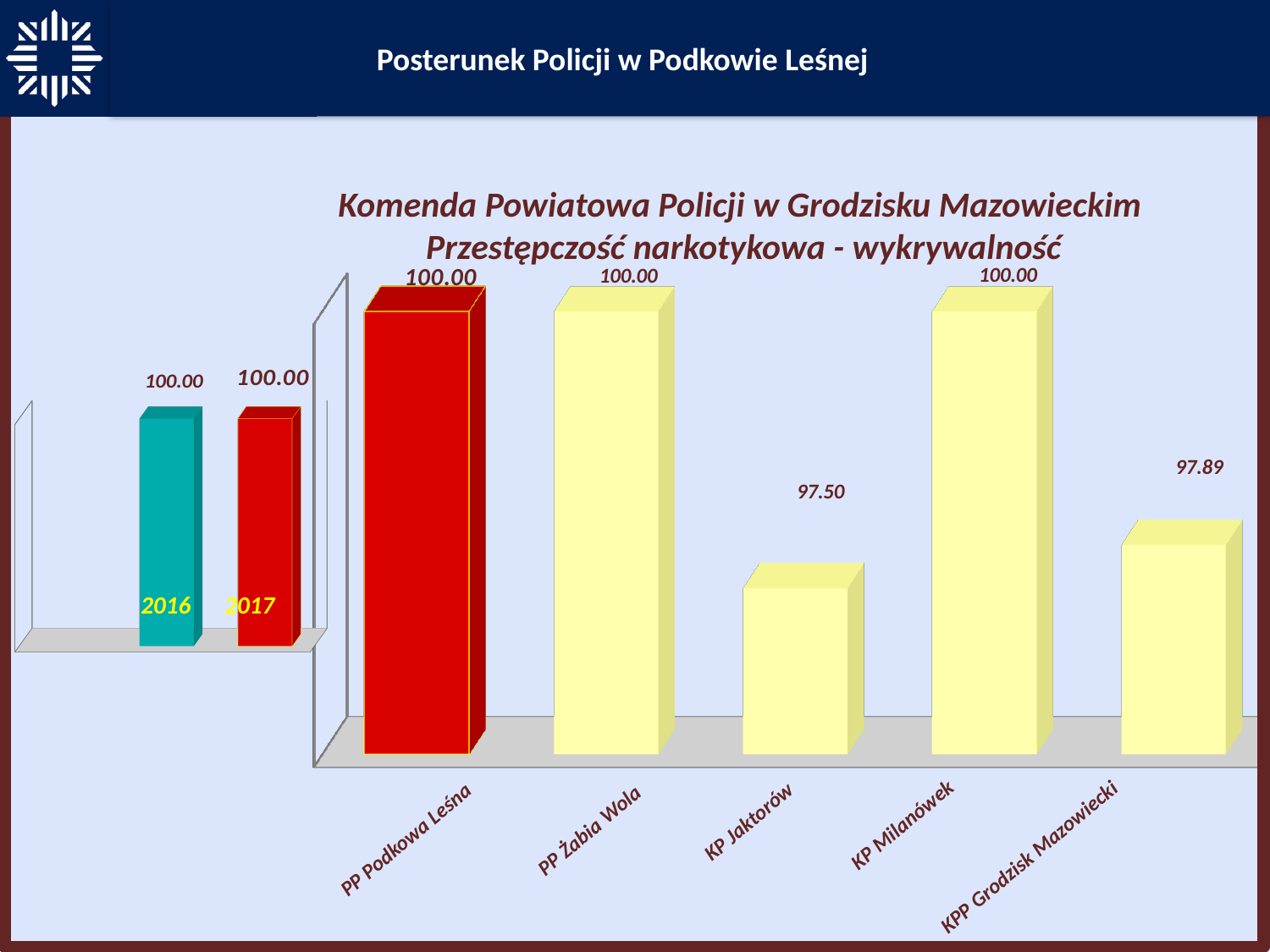
What kind of chart is the large chart titled 'Przestępczość narkotykowa - wykrywalność'? bar chart In the large chart titled 'Przestępczość narkotykowa - wykrywalność', how many categories are shown? 5 In the large chart titled 'Przestępczość narkotykowa - wykrywalność', what is the value for PP Żabia Wola? 100.00 In the small chart on the left, what is the value for 2017? 100.00 In the large chart titled 'Przestępczość narkotykowa - wykrywalność', what is the difference between the values for KPP Grodzisk Mazowiecki and KP Jaktorów? 0.39 In the large chart titled 'Przestępczość narkotykowa - wykrywalność', which is larger, the value for KP Milanówek or the value for KP Jaktorów? KP Milanówek In the large chart titled 'Przestępczość narkotykowa - wykrywalność', what is the value for KP Jaktorów? 97.50 In the small chart on the left, what is the value for 2016? 100.00 In the large chart titled 'Przestępczość narkotykowa - wykrywalność', what colour is the bar for PP Podkowa Leśna? red In the large chart titled 'Przestępczość narkotykowa - wykrywalność', which category has the lowest value? KP Jaktorów In the large chart titled 'Przestępczość narkotykowa - wykrywalność', what is the value for KPP Grodzisk Mazowiecki? 97.89 In the small chart on the left, how many bars are shown? 2